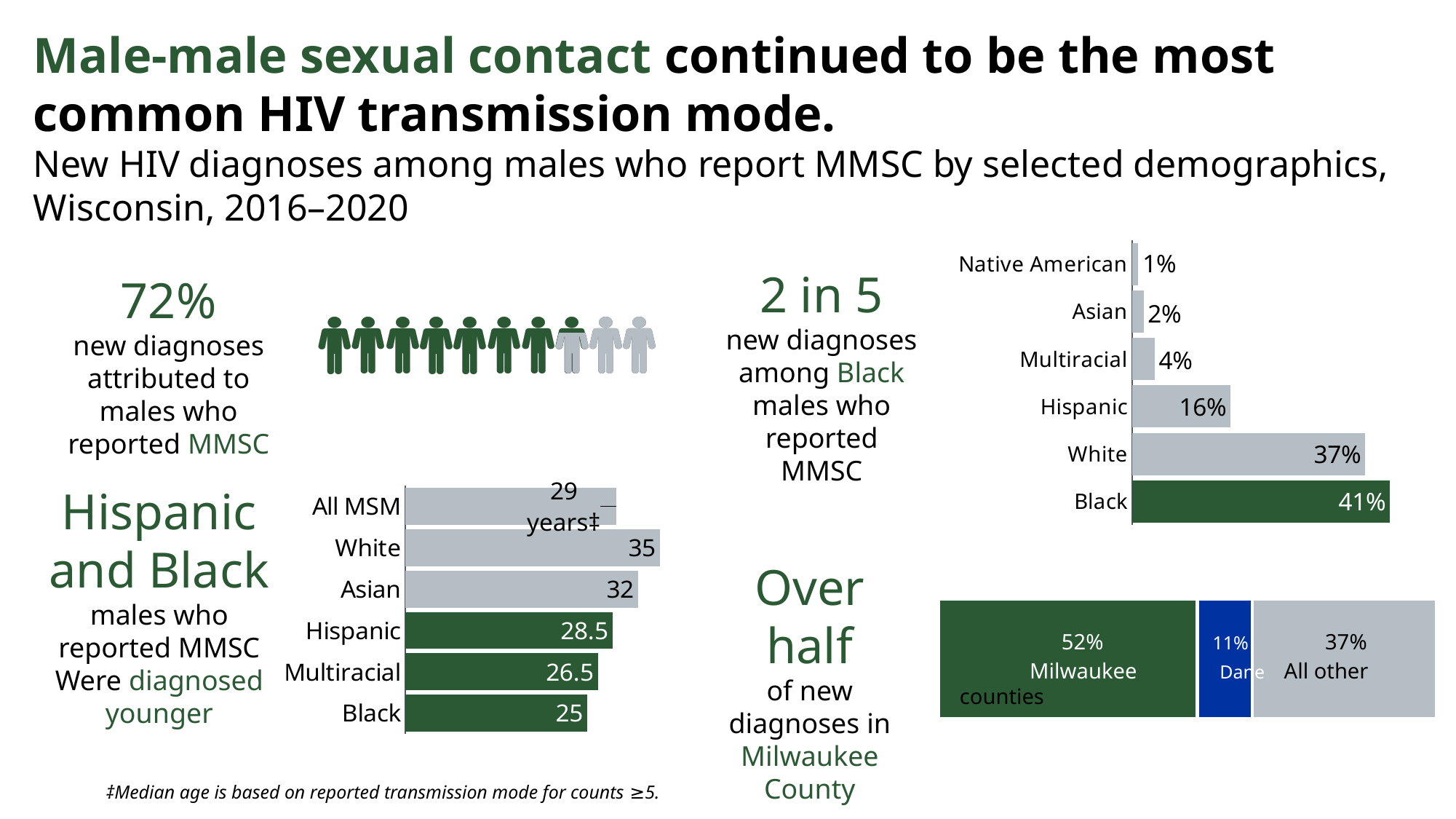
In the race/ethnicity bar chart at the top right, what is the difference between the percentages for Black and White males? 4% In the race/ethnicity bar chart at the top right, which group has the lowest percentage? Native American In the median age bar chart at the bottom left, what is the median age for Hispanic males? 28.5 In the race/ethnicity bar chart at the top right, which group has the highest percentage? Black In the county stacked bar at the bottom right, what percentage of new diagnoses is in Dane County? 11% In the median age bar chart at the bottom left, how many categories are shown? 6 In the median age bar chart at the bottom left, which group has the highest median age? White In the race/ethnicity bar chart at the top right, what percentage of new diagnoses is for Hispanic males? 16% What kind of chart is the race/ethnicity chart at the top right? Bar chart In the median age bar chart at the bottom left, what is the difference between the median ages for White and Black males? 10 In the median age bar chart at the bottom left, which group has the lowest median age? Black In the median age bar chart at the bottom left, what is the median age for White males? 35